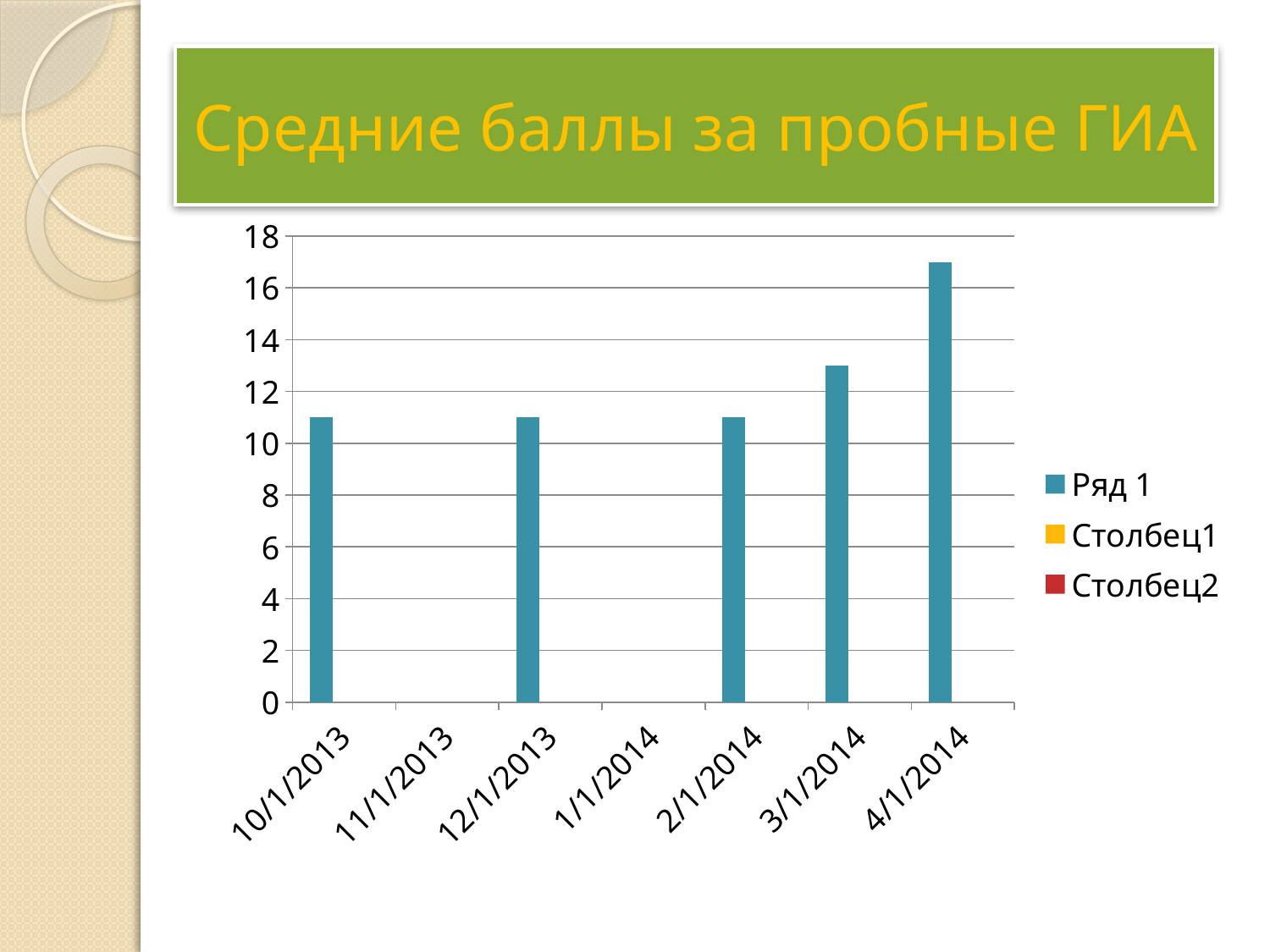
Is the value for 4/1/2014 greater or less than 16? greater What kind of chart is shown on the slide? bar chart How many bars are plotted in the chart? 5 Which date has the highest bar? 4/1/2014 Do the values generally rise or fall from 10/1/2013 to 4/1/2014? rise Is the value for 3/1/2014 greater or less than 12? greater Is the value for 2/1/2014 greater or less than 10? greater Which is larger, the value for 12/1/2013 or the value for 3/1/2014? 3/1/2014 Which is larger, the value for 3/1/2014 or the value for 4/1/2014? 4/1/2014 What is the title of the chart? Средние баллы за пробные ГИА How many series does the legend list? 3